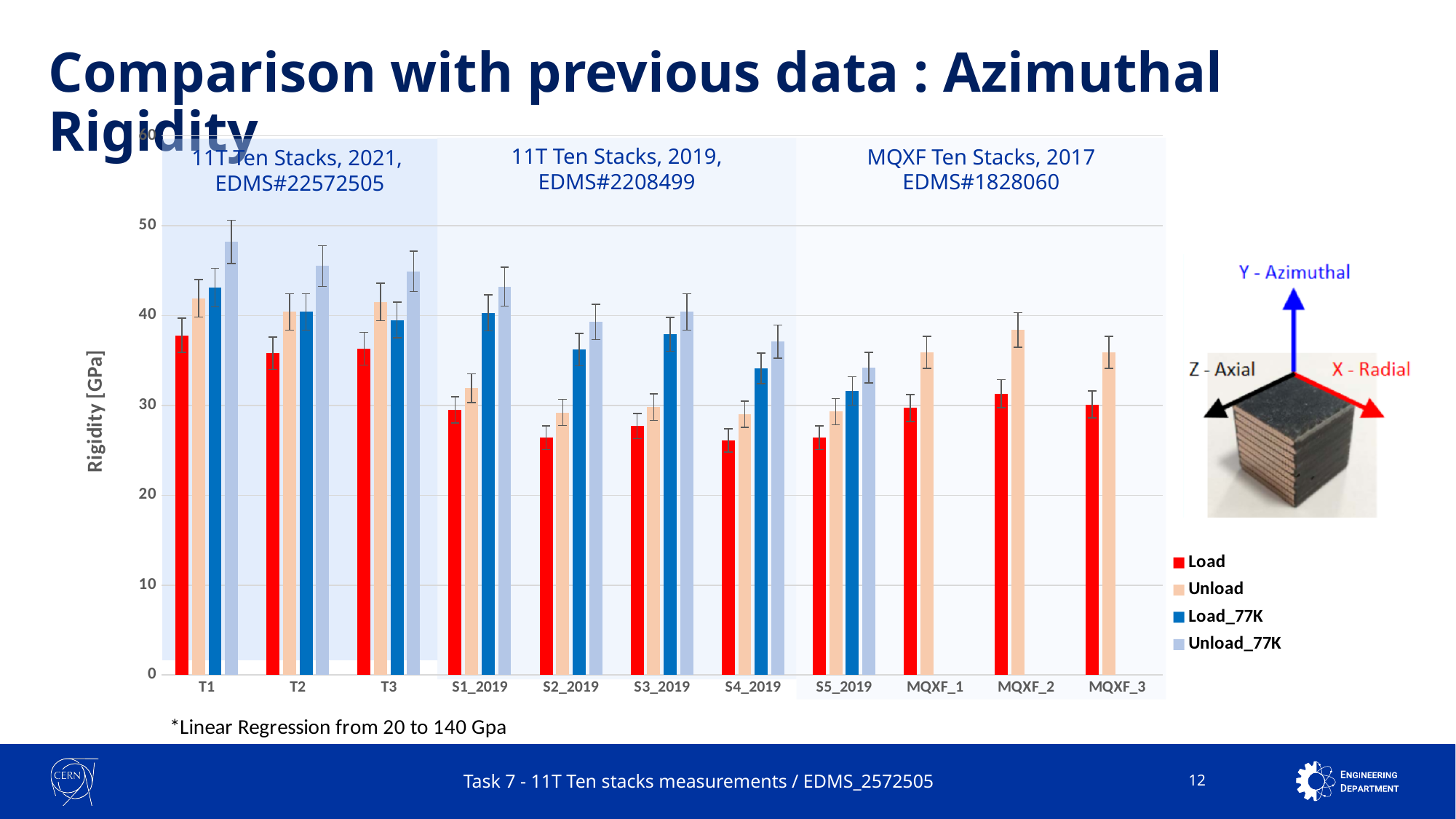
Which is larger, the Unload value for MQXF_2 or the Unload value for MQXF_1? MQXF_2 How many categories are shown along the x axis of the chart? 11 Is the Unload value for MQXF_2 greater or less than 30? greater What kind of chart is shown on the slide? bar chart Is the Unload_77K value for T1 greater or less than 40? greater What is the label of the vertical axis of the chart? Rigidity [GPa] Which colour represents the Load series in the chart legend? red Is the Load value for S2_2019 greater or less than 30? less Which is larger, the Load_77K value for T1 or the Load_77K value for S2_2019? T1 Which category has the highest Unload_77K bar? T1 How many series does the chart legend list? 4